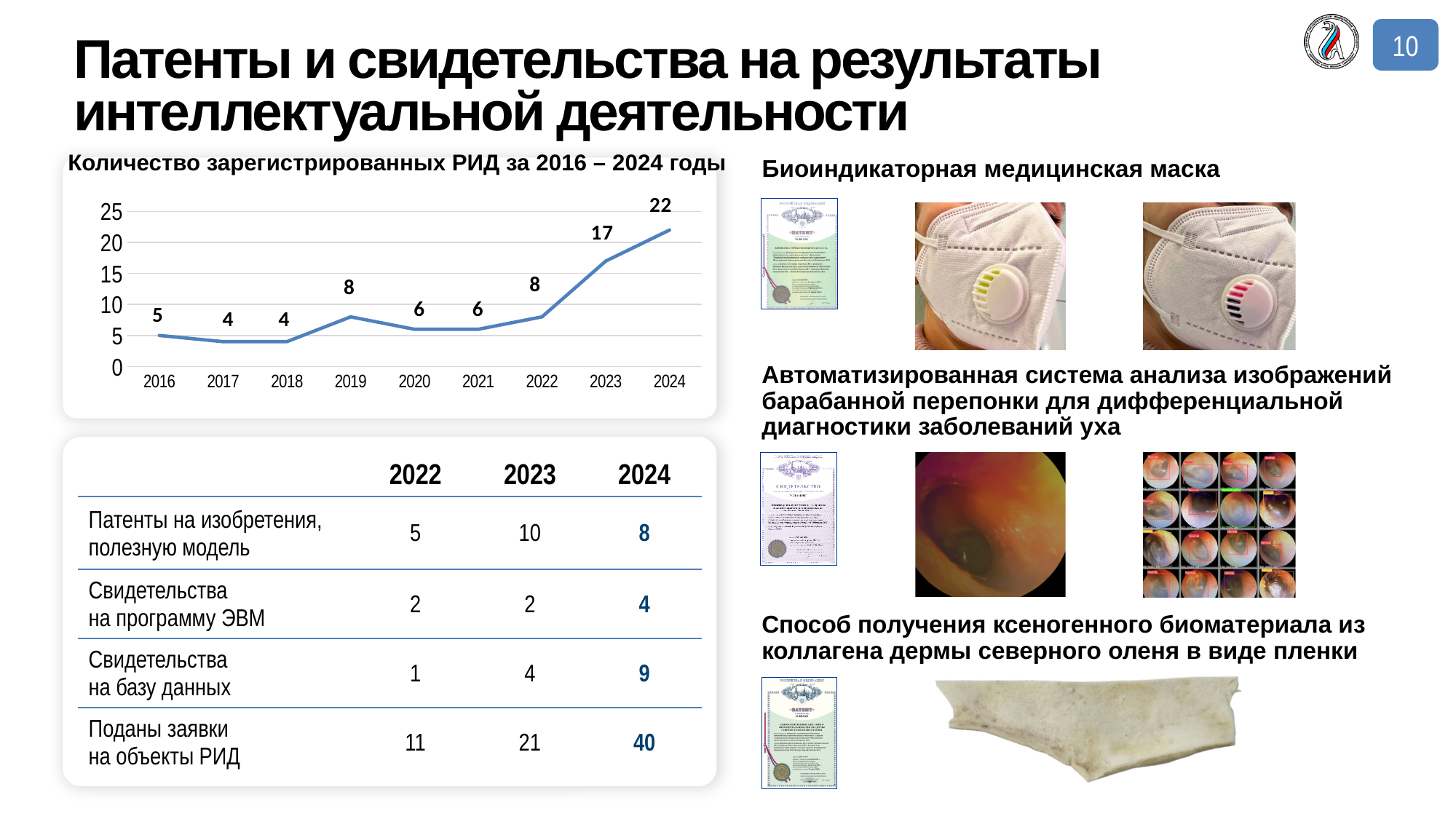
Which year has the highest number of registered RID in the chart? 2024 What is the lowest value shown in the chart of registered RID? 4 In the chart of registered RID, which year has the larger value, 2019 or 2020? 2019 Is the value for 2023 in the chart of registered RID greater or less than 15? greater What is the value for 2024 in the chart of registered RID? 22 What is the title of the line chart on the slide? Количество зарегистрированных РИД за 2016 – 2024 годы What is the difference between the values for 2023 and 2022 in the chart of registered RID? 9 What is the value for 2016 in the chart of registered RID? 5 What is the value for 2019 in the chart of registered RID? 8 What type of chart is used to show the number of registered RID for 2016–2024? line chart What is the difference between the values for 2024 and 2023 in the chart of registered RID? 5 How many years are plotted on the x axis of the chart of registered RID? 9